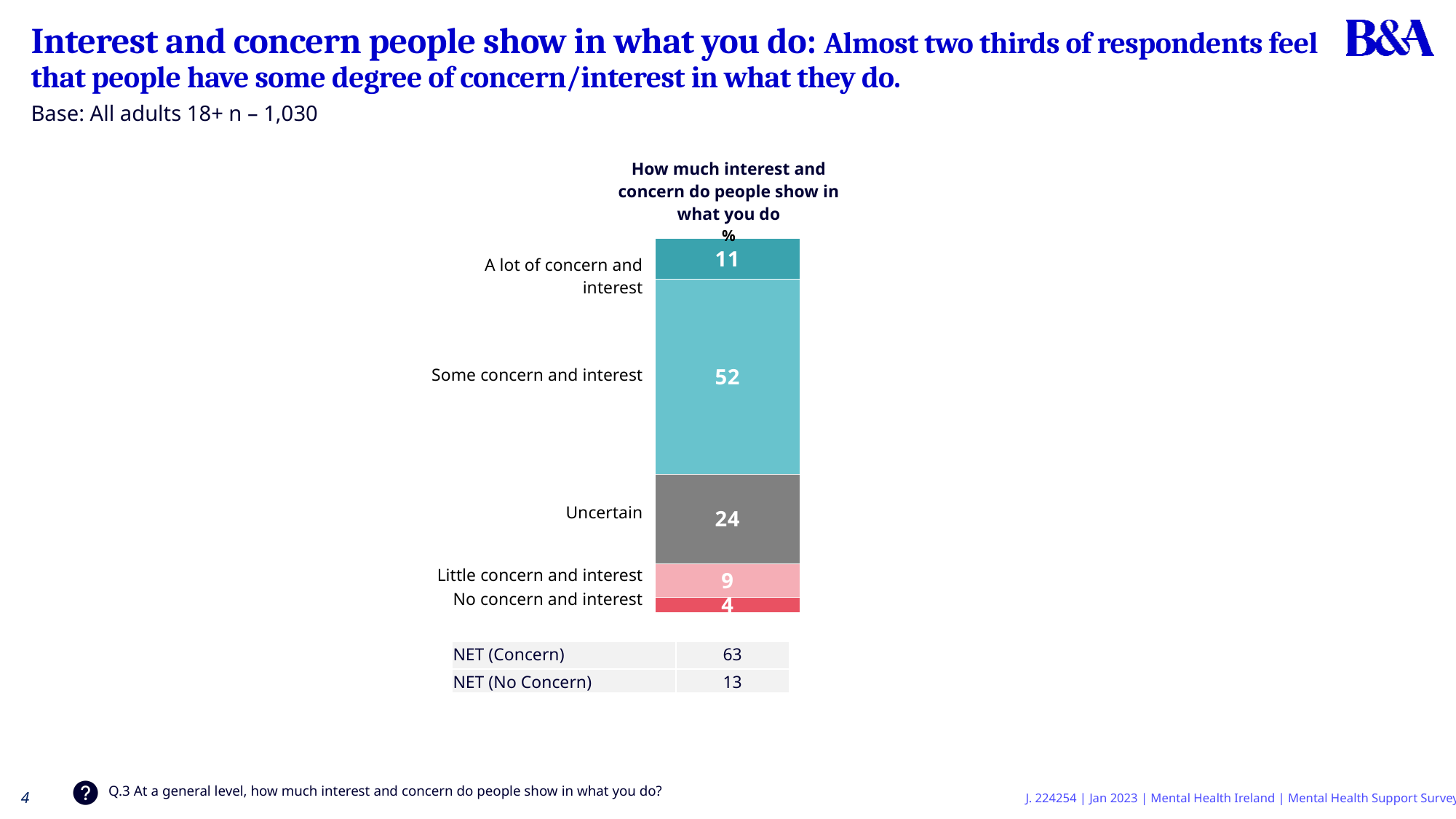
What is the NET (Concern) figure shown below the chart? 63 How many response categories are shown in the stacked bar? 5 Which response category has the highest percentage? Some concern and interest Which is larger: the percentage for 'A lot of concern and interest' or for 'Little concern and interest'? A lot of concern and interest What is the total of the stacked bar segments? 100 What percentage of respondents are uncertain about how much interest and concern people show? 24 What type of chart is used to show how much interest and concern people show? Stacked bar chart What percentage of respondents say people show no concern and interest in what they do? 4 Which response category has the lowest percentage? No concern and interest What is the difference in percentage points between 'Some concern and interest' and 'Uncertain'? 28 What percentage of respondents say people show some concern and interest in what they do? 52 What percentage of respondents say people show a lot of concern and interest in what they do? 11